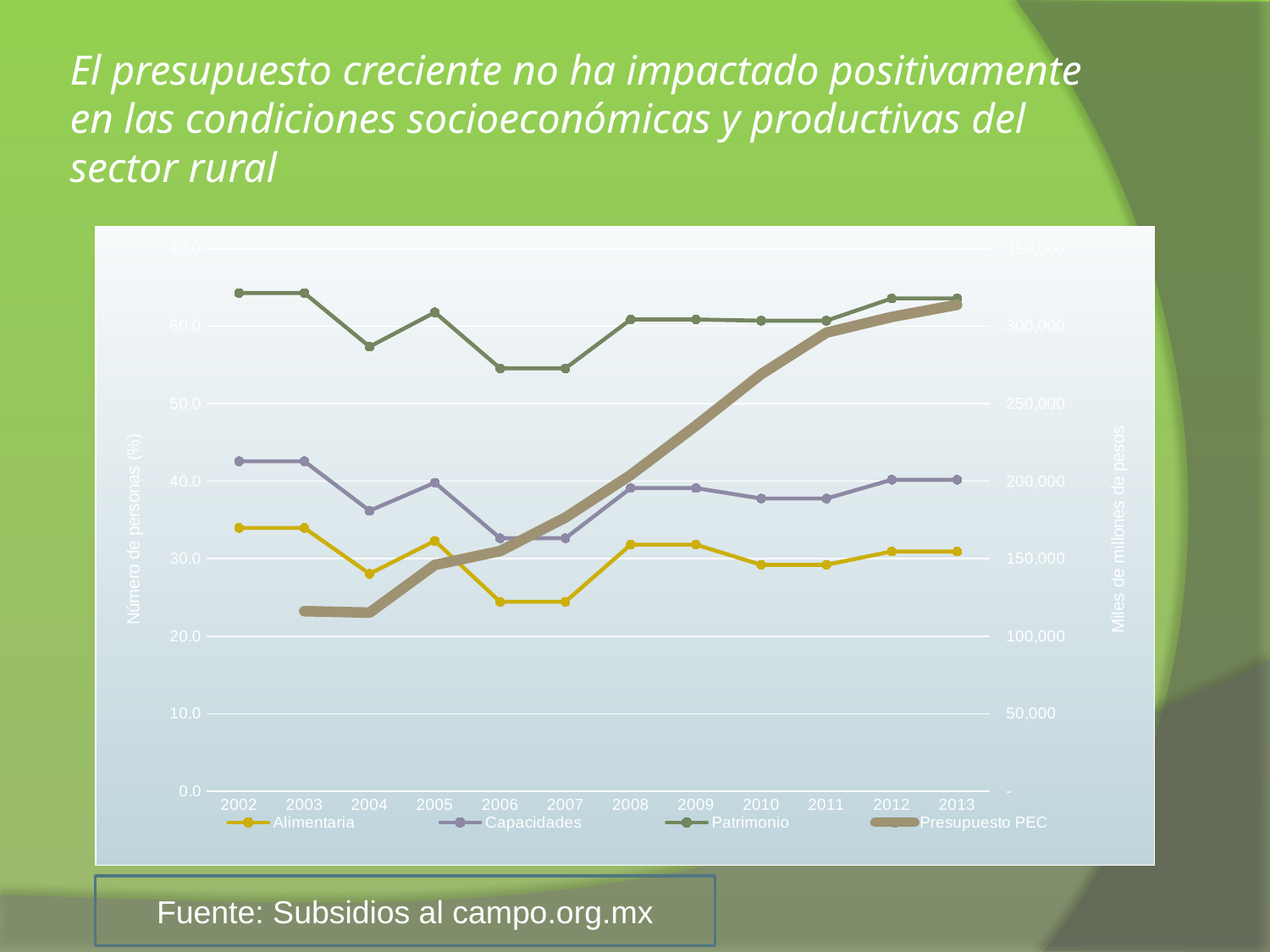
How many years are shown on the x axis? 12 Is the value for Patrimonio in 2002 greater or less than 60.0? greater Among Alimentaria, Capacidades and Patrimonio, which series has the lowest value in 2010? Alimentaria What is the title of the right vertical axis? Miles de millones de pesos What kind of chart is shown on the slide? line chart What is the title of the left vertical axis? Número de personas (%) Is the value for Alimentaria in 2006 greater or less than 30.0? less Is the value for Presupuesto PEC in 2013 greater or less than 300,000? greater Does the Presupuesto PEC line rise or fall from 2003 to 2013? rise How many series does the legend list? 4 In 2008, which is larger: Patrimonio or Alimentaria? Patrimonio